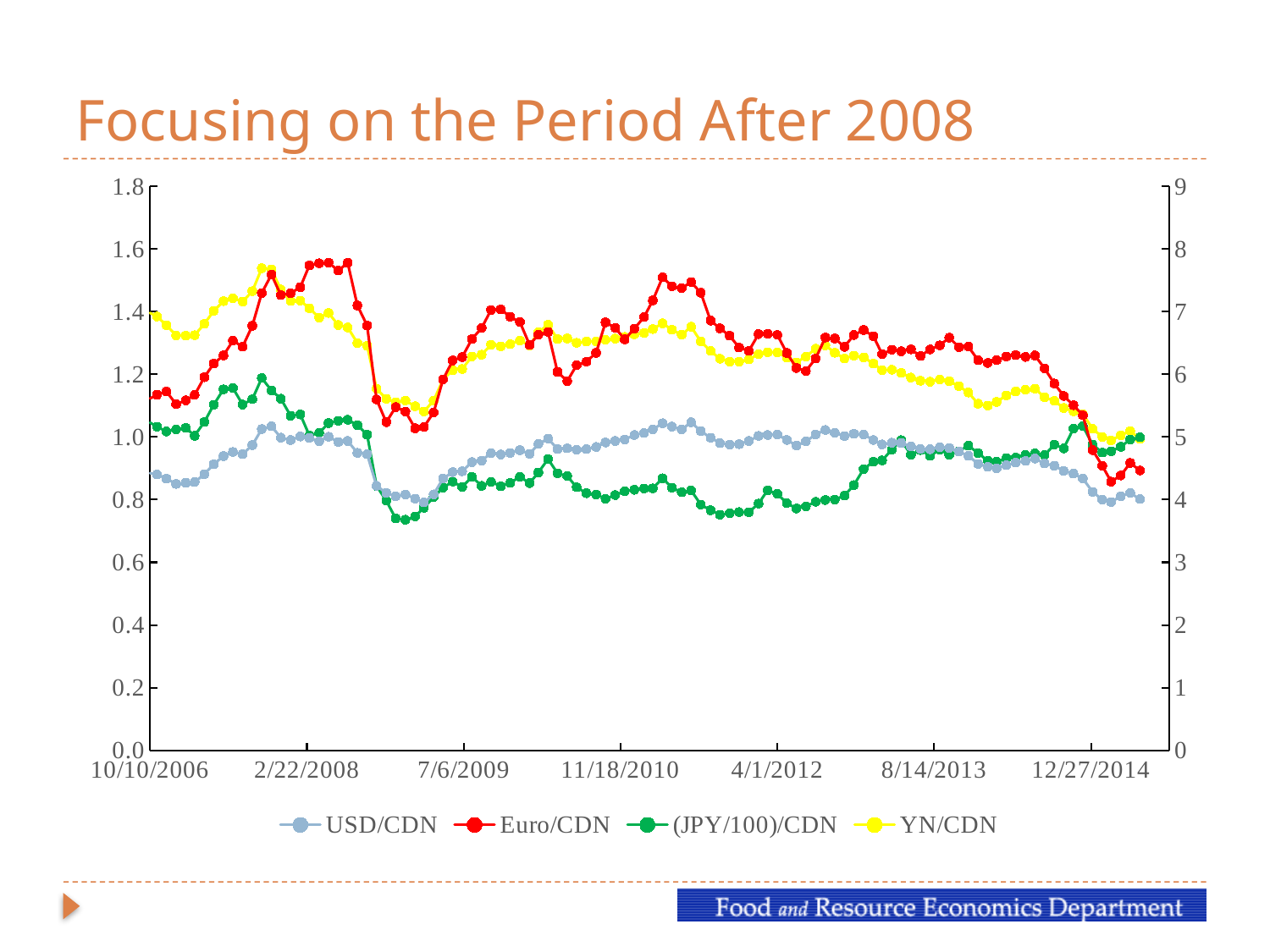
What is the title of the slide containing the chart? Focusing on the Period After 2008 What are the series names listed in the legend? USD/CDN, Euro/CDN, (JPY/100)/CDN, YN/CDN At 7/6/2009, which series is higher, Euro/CDN or USD/CDN? Euro/CDN On the left axis, is the value for Euro/CDN at 2/22/2008 greater or less than 1.4? greater What kind of chart is shown on the slide? line chart On the left axis, is the value for (JPY/100)/CDN at 4/1/2012 greater or less than 1.0? less Around 4/1/2012, which series has the lowest value? (JPY/100)/CDN At 2/22/2008, which series is higher, Euro/CDN or (JPY/100)/CDN? Euro/CDN How many series does the legend list? 4 Does the Euro/CDN series rise or fall between 8/14/2013 and 12/27/2014? fall On the left axis, is the value for USD/CDN at 10/10/2006 greater or less than 1.0? less